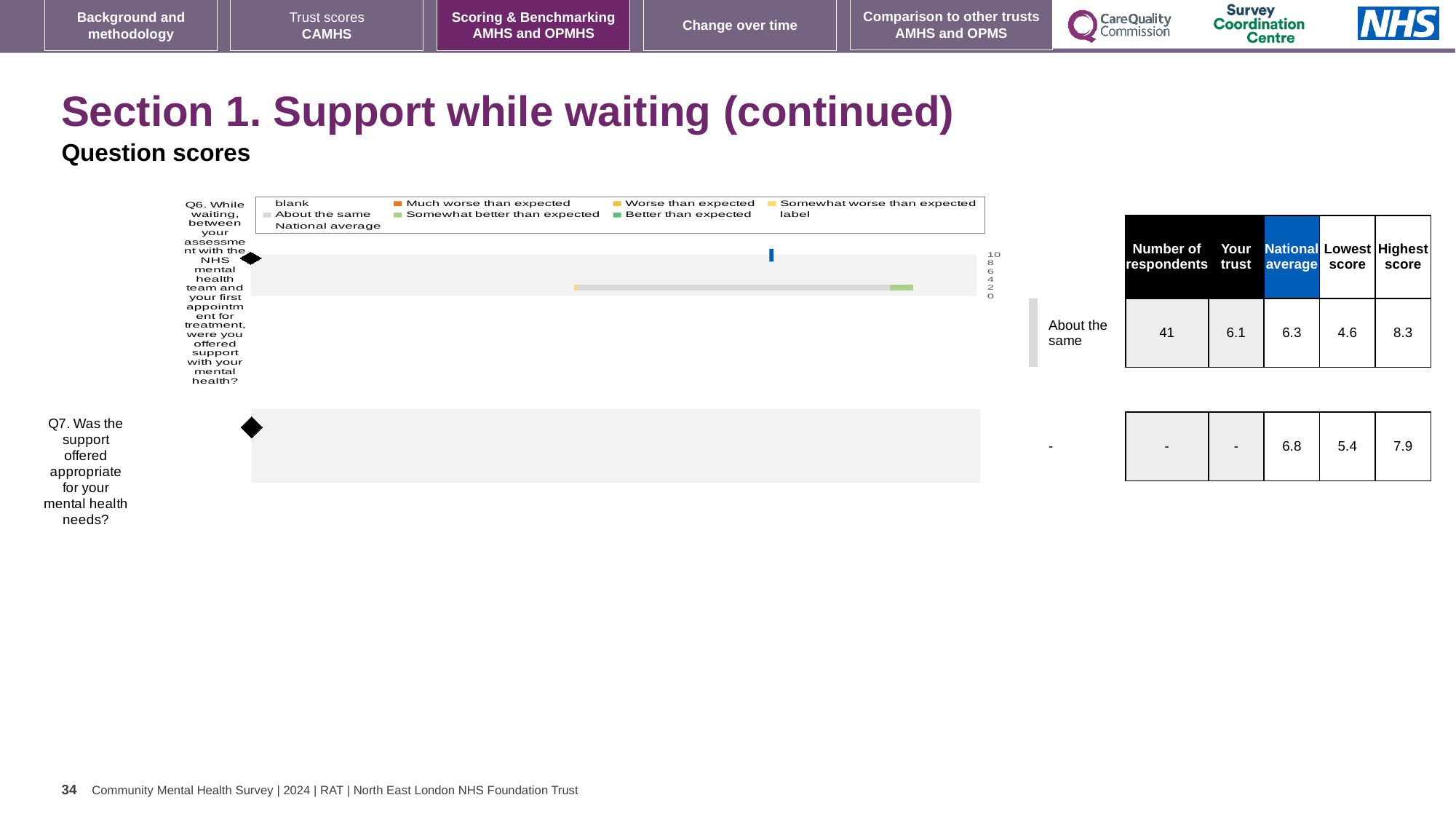
What benchmark category is shown for Q6 next to the chart? About the same What kind of chart is used to show the question scores on this slide? bar chart How many survey questions (categories) are plotted on the chart? 2 What is the 'Your trust' score for Q6 in the table beside the chart? 6.1 What is the national average score for Q6? 6.3 What is the difference between the highest score and the lowest score for Q6? 3.7 In the chart legend, what colour represents 'Better than expected'? green What is the national average score for Q7? 6.8 What is the difference between the highest score and the lowest score for Q7? 2.5 For Q6, which is larger: the 'Your trust' score or the national average? National average According to the table next to the chart, how many respondents answered Q6? 41 What is the maximum value shown on the chart's score axis? 10